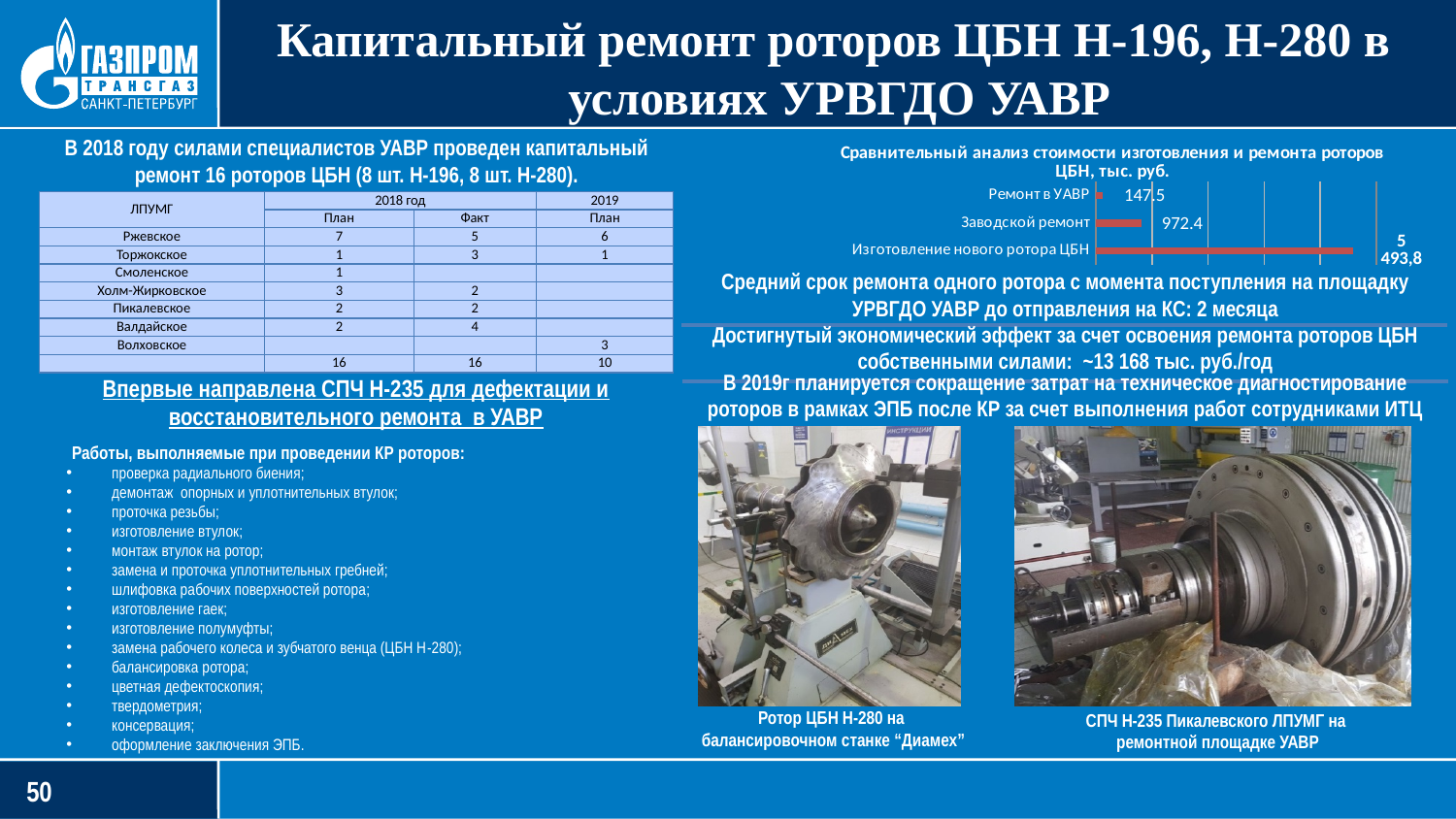
What is the title of the chart on the slide? Сравнительный анализ стоимости изготовления и ремонта роторов ЦБН, тыс. руб. Which is larger in the chart: "Заводской ремонт" or "Ремонт в УАВР"? Заводской ремонт What is the difference between "Заводской ремонт" and "Ремонт в УАВР" in the chart? 824,9 What is the value for "Изготовление нового ротора ЦБН" in the chart? 5 493,8 What is the difference between "Изготовление нового ротора ЦБН" and "Заводской ремонт" in the chart? 4 521,4 What kind of chart is shown under the title "Сравнительный анализ стоимости изготовления и ремонта роторов ЦБН, тыс. руб."? Bar chart What unit is stated in the chart title? тыс. руб. How many categories are shown in the chart? 3 What is the value for "Ремонт в УАВР" in the chart? 147,5 Which category has the lowest value in the chart? Ремонт в УАВР What is the value for "Заводской ремонт" in the chart? 972,4 Which category has the highest value in the chart? Изготовление нового ротора ЦБН